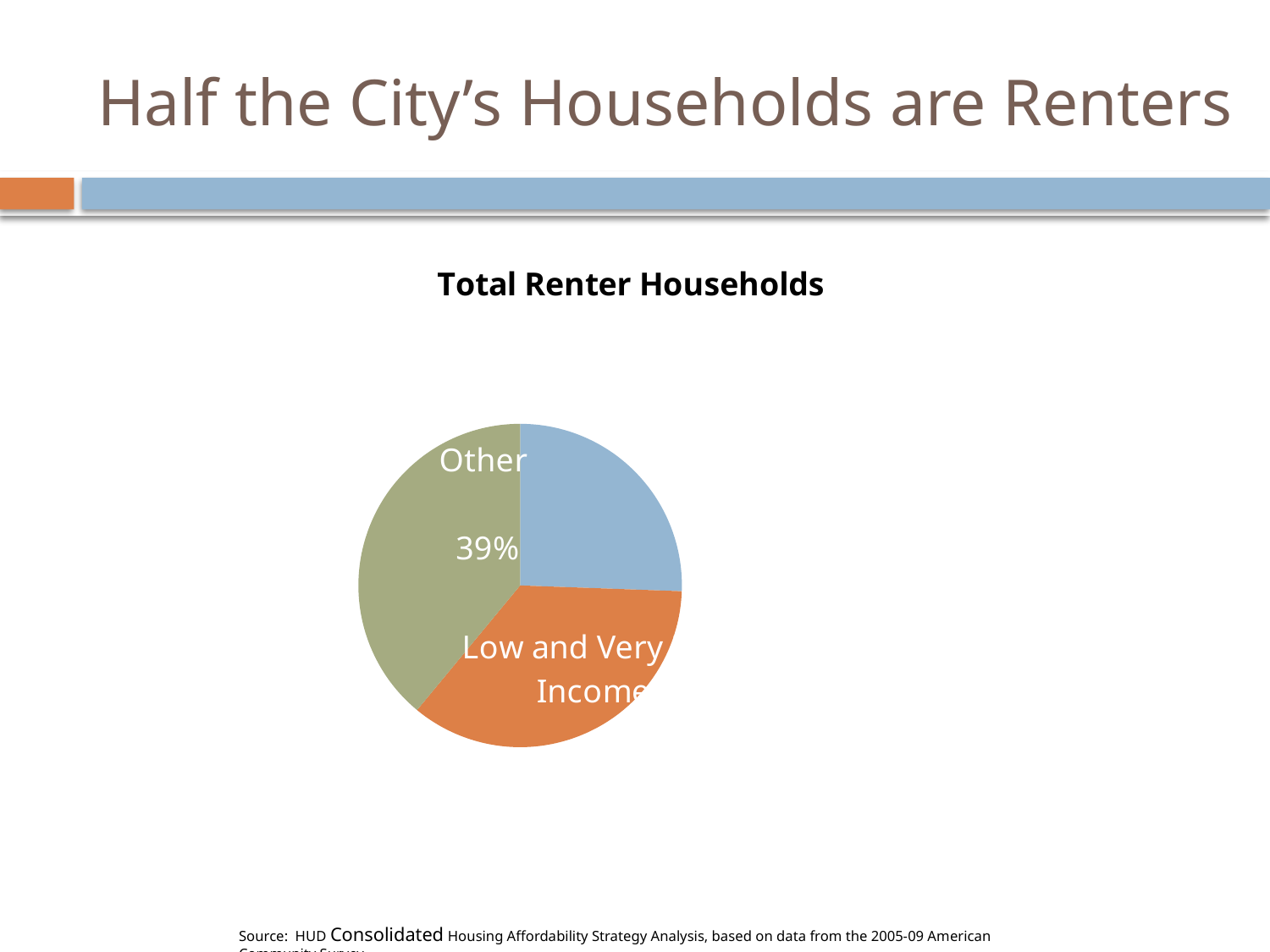
What share of total renter households is labelled "Other"? 39% What colour is the "Other" slice of the pie chart? Green How many slices does the pie chart have? 3 What kind of chart is shown on the slide? Pie chart Which is larger: the "Other" slice or the orange "Low and Very Low Income" slice? Other Which slice of the pie chart is the largest? Other Is the share for "Other" greater or less than 50%? less What is the title of the chart? Total Renter Households